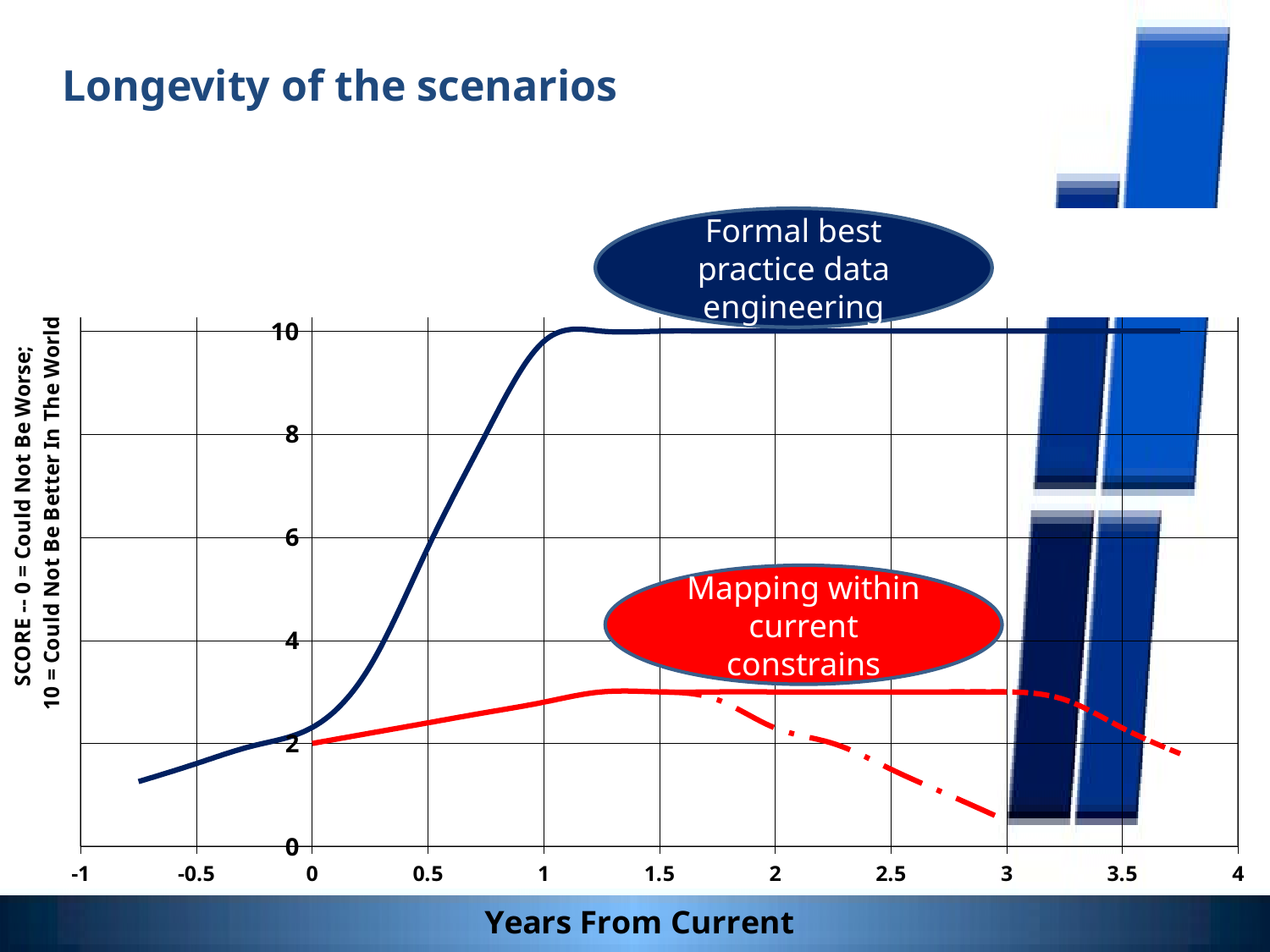
What is the title of the chart on the slide? Longevity of the scenarios What score does the 'Mapping within current constrains' line start at, at 0 years from current? 2 Is the score for 'Mapping within current constrains' at 1 year greater or less than 4? less At 2 years from current, which scenario has the higher score: 'Formal best practice data engineering' or 'Mapping within current constrains'? Formal best practice data engineering What score does the 'Formal best practice data engineering' line reach at 2 years from current? 10 How many scenarios (lines) are plotted on the chart? 2 Is the score of the dash-dot branch of 'Mapping within current constrains' at 3 years greater or less than 2? less Is the score for 'Formal best practice data engineering' at 1.5 years greater or less than 8? greater What is the label of the x axis? Years From Current Does the 'Formal best practice data engineering' line rise or fall between 0 and 1 years from current? rise What kind of chart is shown on the slide? line chart Which scenario has the lowest score at 3 years from current? Mapping within current constrains